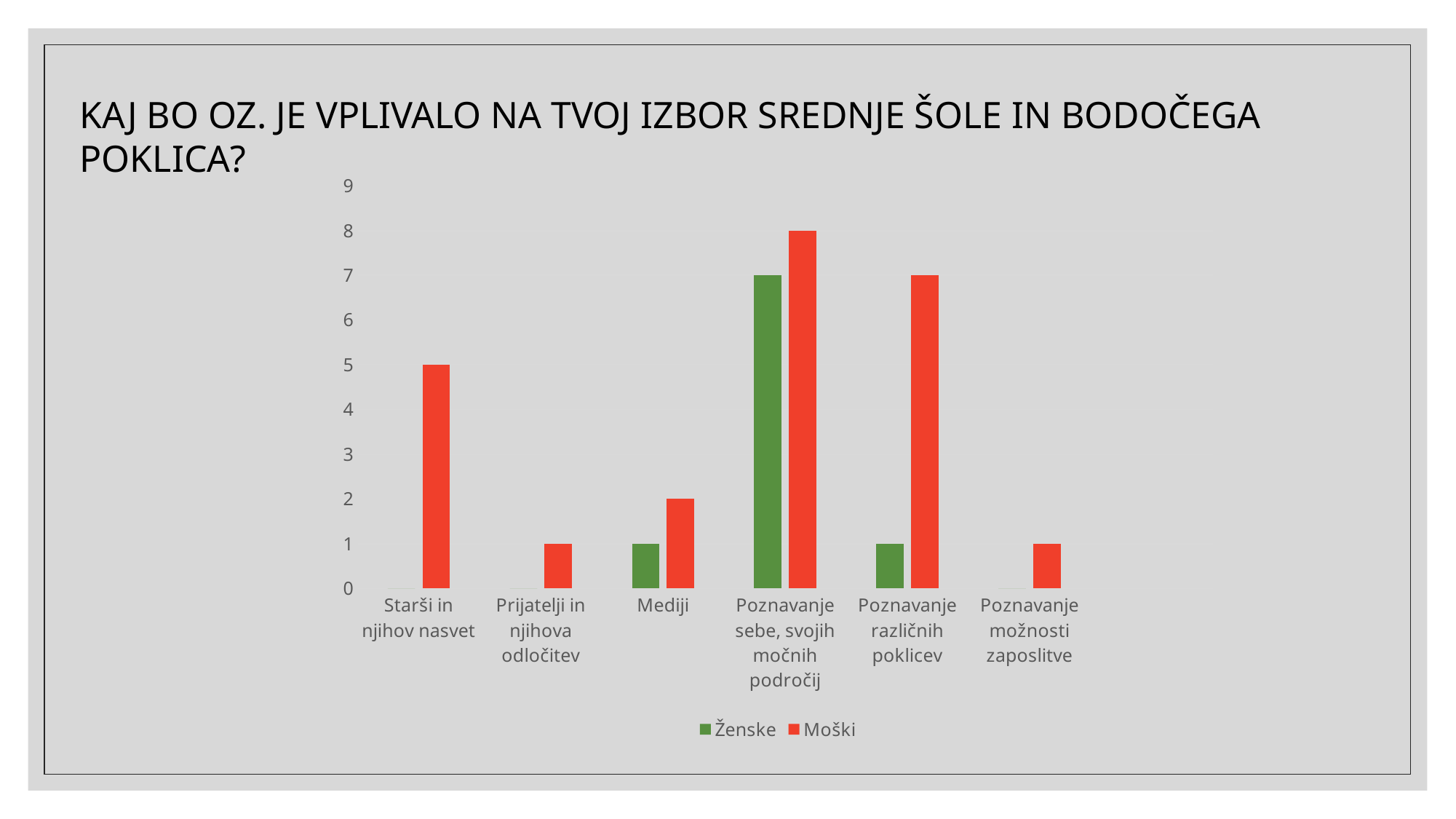
Which series is shown in red in the legend? Moški What is the difference between the Moški and Ženske values in the category Poznavanje različnih poklicev? 6 What is the value for Moški in the category Starši in njihov nasvet? 5 What is the value for Ženske in the category Poznavanje sebe, svojih močnih področij? 7 What kind of chart is shown on the slide? bar chart What is the value for Moški in the category Poznavanje različnih poklicev? 7 Which category has the highest value for Moški? Poznavanje sebe, svojih močnih področij What is the value for Moški in the category Mediji? 2 Which is larger in the category Mediji, the value for Ženske or for Moški? Moški How many series does the legend list? 2 Which category has the highest value for Ženske? Poznavanje sebe, svojih močnih področij How many categories are shown on the x axis? 6